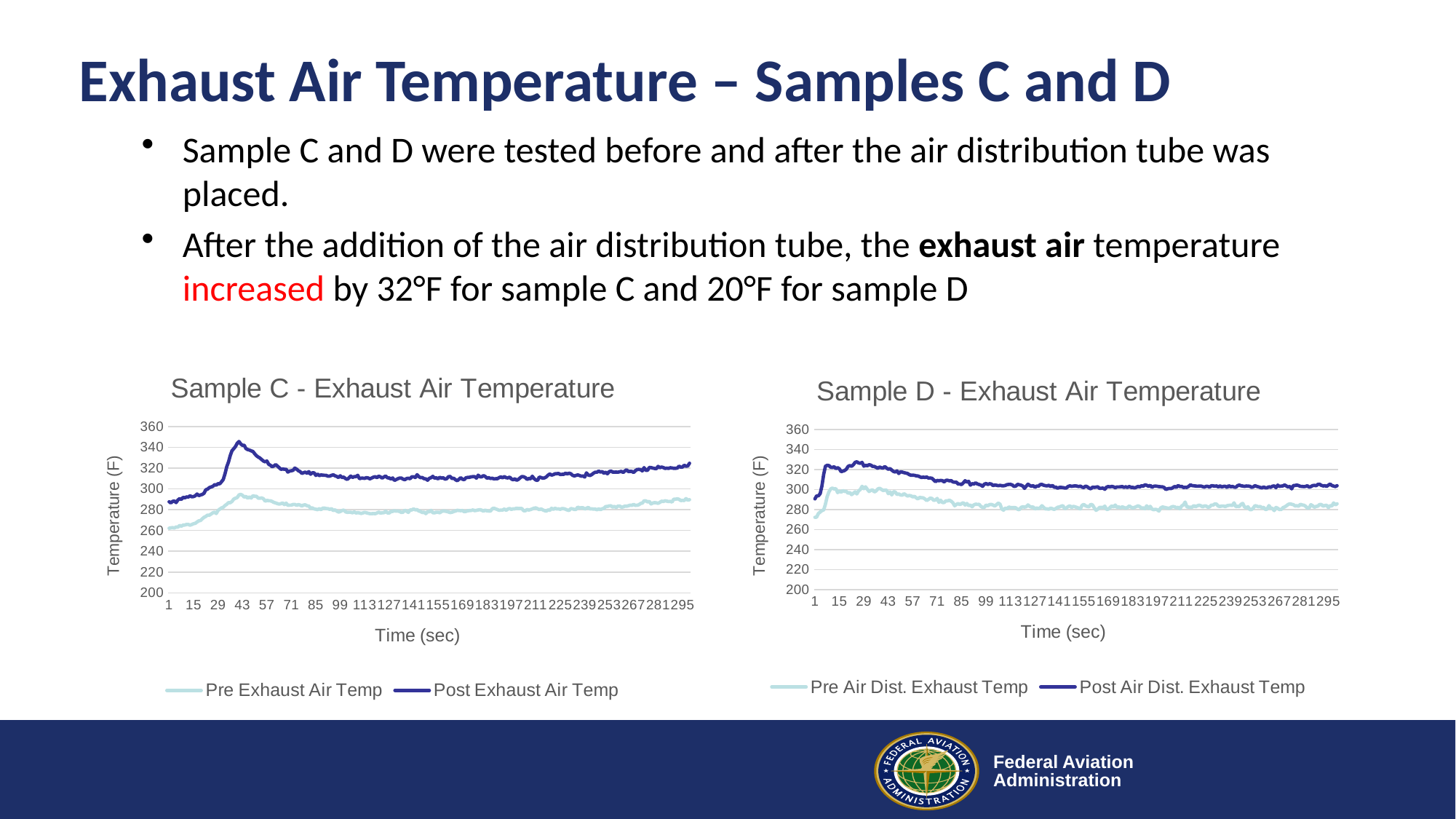
In the "Sample C - Exhaust Air Temperature" chart, what are the two series named in the legend? Pre Exhaust Air Temp and Post Exhaust Air Temp In the "Sample D - Exhaust Air Temperature" chart, which series is higher at time 155, Pre Air Dist. Exhaust Temp or Post Air Dist. Exhaust Temp? Post Air Dist. Exhaust Temp In the "Sample C - Exhaust Air Temperature" chart, does the Post Exhaust Air Temp series rise or fall between time 43 and time 99? fall In the "Sample C - Exhaust Air Temperature" chart, is the Pre Exhaust Air Temp value at time 1 greater or less than 280? less In the "Sample D - Exhaust Air Temperature" chart, is the peak value of the Post Air Dist. Exhaust Temp series greater or less than 340? less How many series does the legend of the "Sample D - Exhaust Air Temperature" chart list? 2 In the "Sample C - Exhaust Air Temperature" chart, is the peak value of the Post Exhaust Air Temp series greater or less than 340? greater In the "Sample D - Exhaust Air Temperature" chart, what is the label of the y axis? Temperature (F) What kind of chart is the "Sample C - Exhaust Air Temperature" chart? line chart In the "Sample C - Exhaust Air Temperature" chart, which series is higher at time 295, Pre Exhaust Air Temp or Post Exhaust Air Temp? Post Exhaust Air Temp